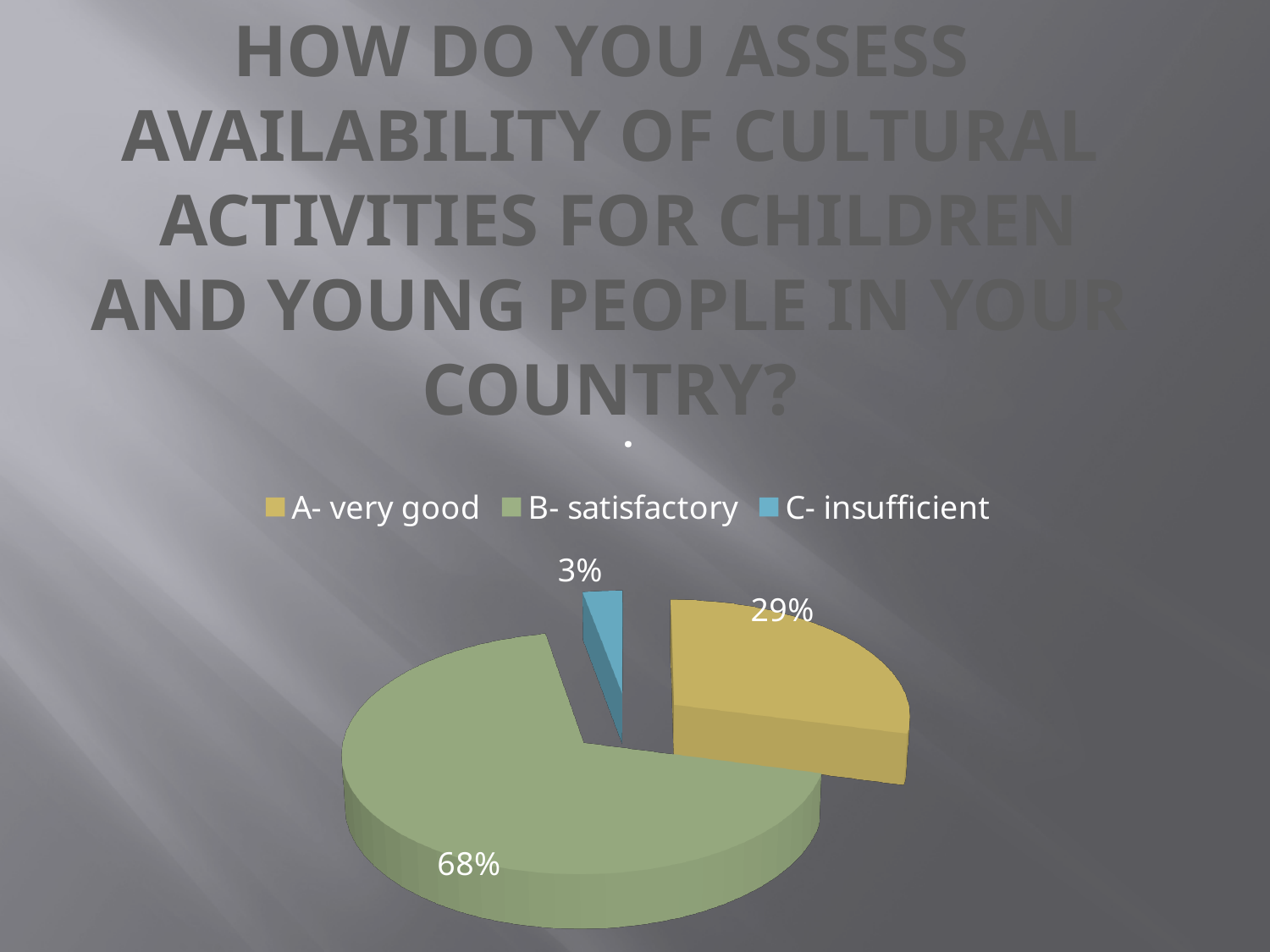
What is the difference in percentage points between 'B- satisfactory' and 'A- very good'? 39 What kind of chart is shown on the slide? pie chart Which colour represents 'C- insufficient' in the legend? blue What share of the pie is labelled 'B- satisfactory'? 68% Which colour represents 'A- very good' in the legend? yellow Which is larger, the share for 'A- very good' or the share for 'C- insufficient'? A- very good What share of the pie is labelled 'C- insufficient'? 3% What share of the pie is labelled 'A- very good'? 29% How many categories does the pie chart show? 3 Which category has the smallest slice of the pie? C- insufficient Which category has the largest slice of the pie? B- satisfactory What is the difference in percentage points between 'A- very good' and 'C- insufficient'? 26